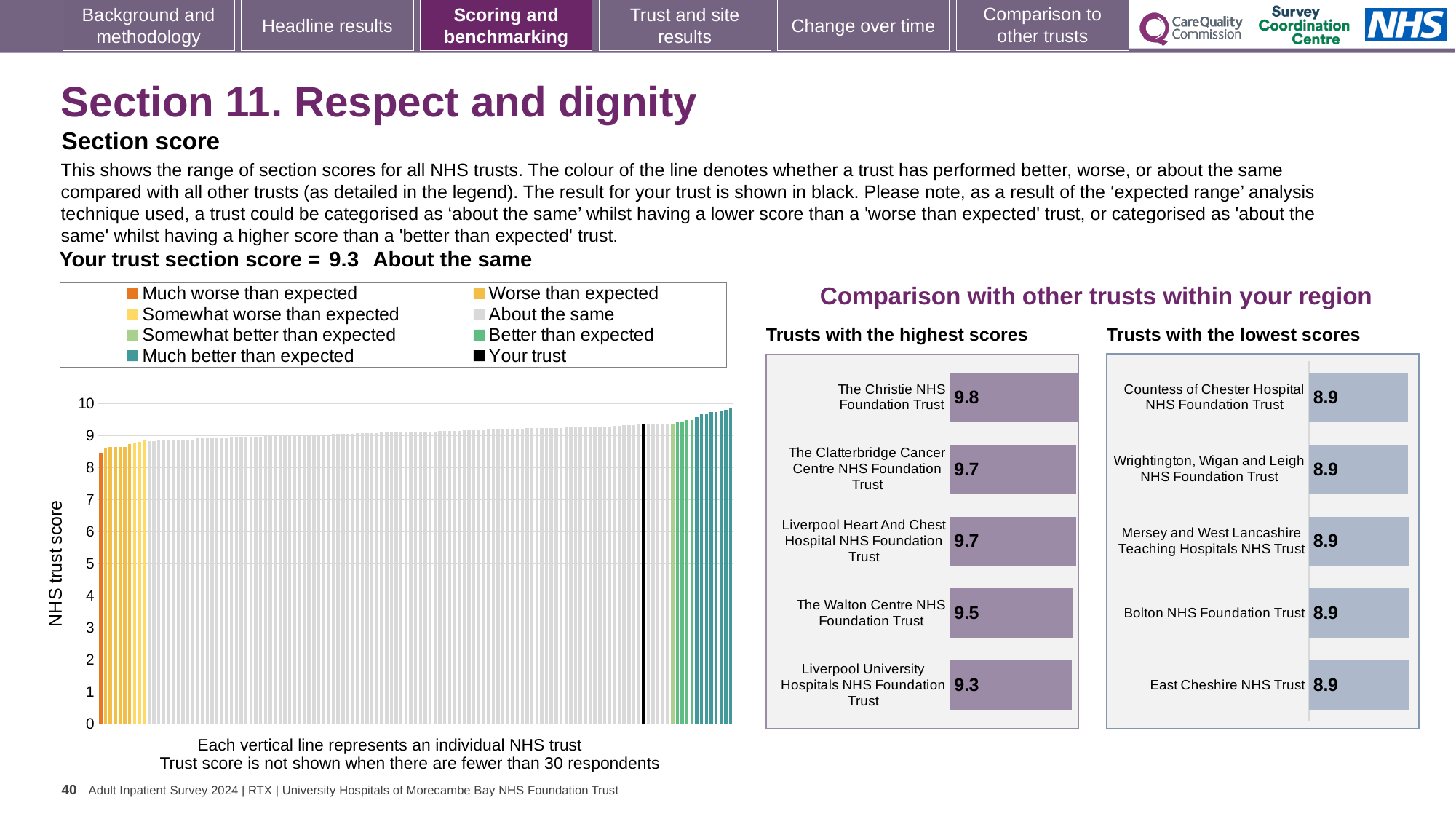
In the 'Trusts with the lowest scores' chart, what is the score for Bolton NHS Foundation Trust? 8.9 In the large chart on the left, do the trust scores rise or fall from left to right along the x axis? Rise How many entries does the legend of the large chart on the left list? 8 In the 'Trusts with the highest scores' chart, what is the difference between the scores of The Christie NHS Foundation Trust and The Walton Centre NHS Foundation Trust? 0.3 In the 'Trusts with the highest scores' chart, which trust has the lowest score? Liverpool University Hospitals NHS Foundation Trust In the 'Trusts with the lowest scores' chart, what is the score for East Cheshire NHS Trust? 8.9 In the 'Trusts with the highest scores' chart, how many trusts are listed? 5 In the 'Trusts with the lowest scores' chart, how many trusts are listed? 5 In the 'Trusts with the highest scores' chart, which trust has the highest score? The Christie NHS Foundation Trust In the 'Trusts with the highest scores' chart, what is the score for The Christie NHS Foundation Trust? 9.8 What kind of chart is the large chart on the left showing NHS trust scores? Bar chart In the 'Trusts with the highest scores' chart, what is the score for The Walton Centre NHS Foundation Trust? 9.5